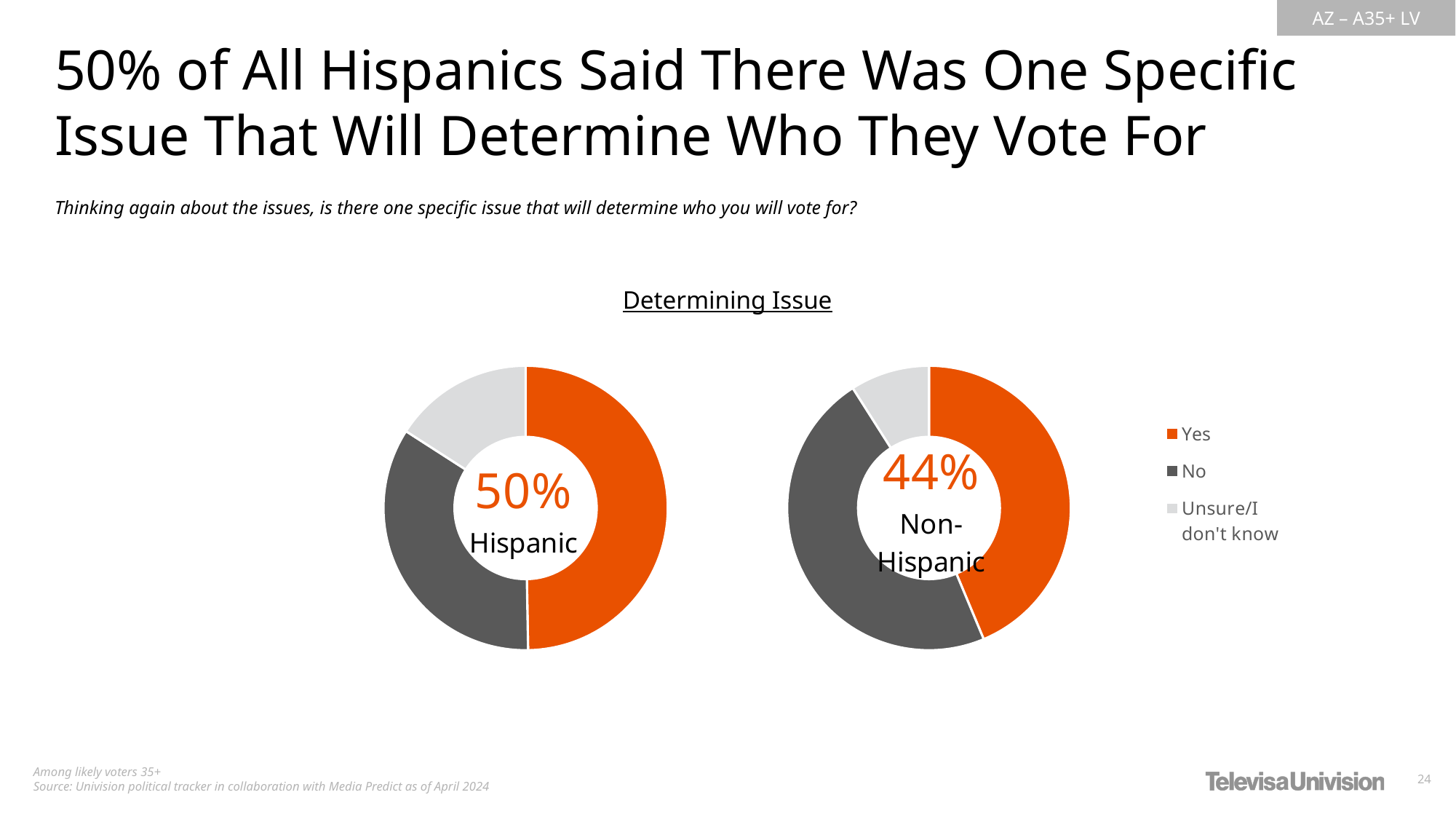
How many donut charts are shown on the slide? 2 In the Non-Hispanic chart, which response is the smallest slice? Unsure/I don't know How many series does the legend list? 3 What kind of chart is used to show the Determining Issue data? Donut (pie) chart Which colour represents the Yes response in the legend? Orange What is the title shown above the charts? Determining Issue Which group has the larger Yes share, Hispanic or Non-Hispanic? Hispanic In the Hispanic chart, which response is the smallest slice? Unsure/I don't know What is the difference in percentage points between the Hispanic Yes share (50%) and the Non-Hispanic Yes share (44%)? 6 percentage points In the Hispanic chart, which response is the largest slice? Yes In the Hispanic chart, what percentage said Yes, there is one specific issue that will determine who they vote for? 50% In the Non-Hispanic chart, what percentage said Yes? 44%